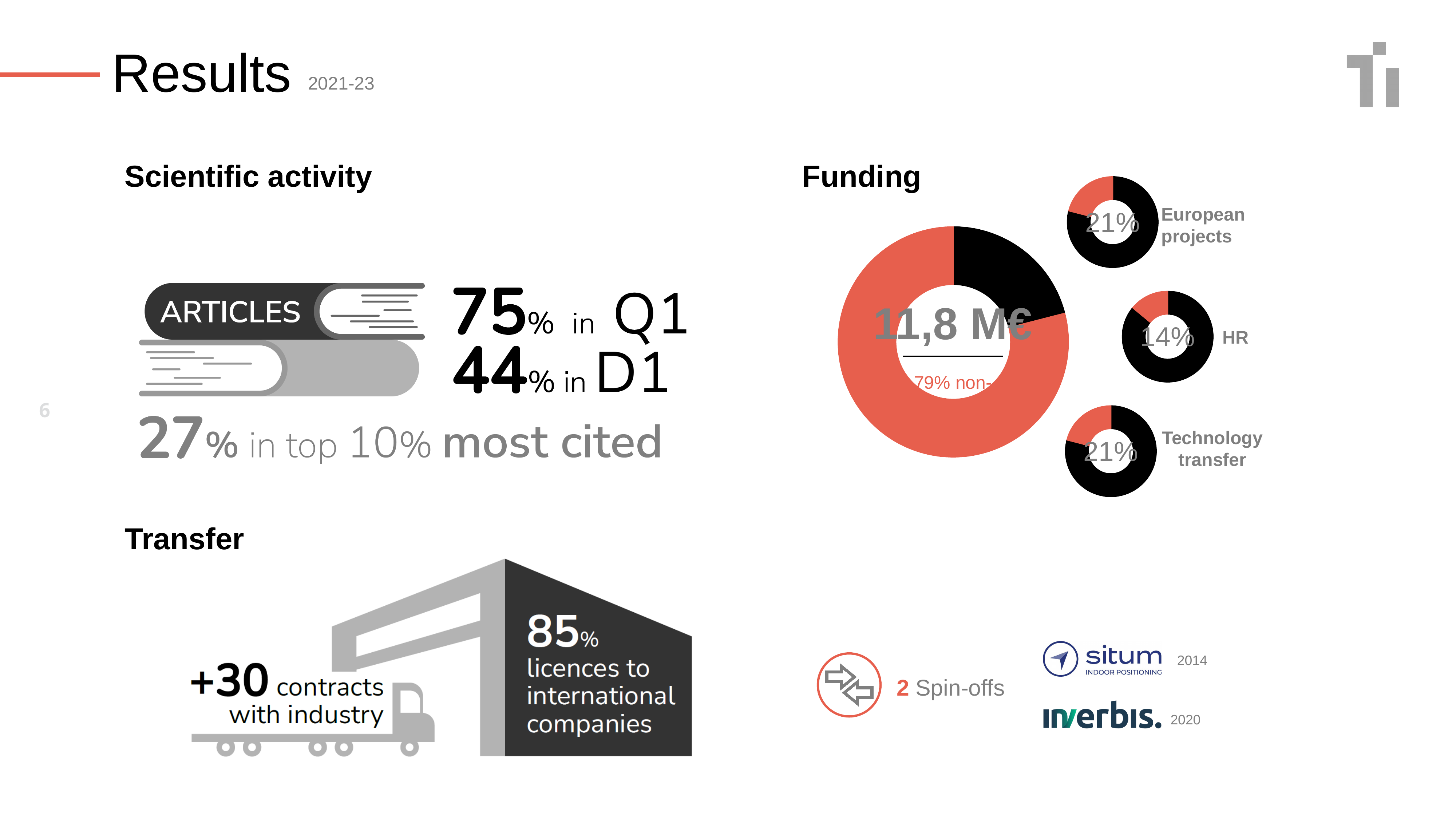
In the Funding section, what is the difference in percentage points between European projects (21%) and HR (14%)? 7 percentage points Among the three small donut charts in the Funding section (European projects, HR, Technology transfer), which has the lowest percentage? HR In the Funding section, what percentage is shown for Technology transfer? 21% In the Funding section, what percentage is shown for European projects? 21% What colour is the larger slice of the big donut chart in the Funding section? Red In the Funding section, what total amount is printed in the centre of the large donut chart? 11,8 M€ In the large Funding donut chart, which slice is larger: the red one or the black one? The red one In the Funding section, which two categories share the same percentage value? European projects and Technology transfer In the Funding section, which is larger: the percentage for European projects or for HR? European projects How many small donut charts surround the large donut chart in the Funding section? 3 What kind of chart is used in the Funding section of the slide? Donut (pie) chart In the Funding section, what percentage is shown for HR? 14%